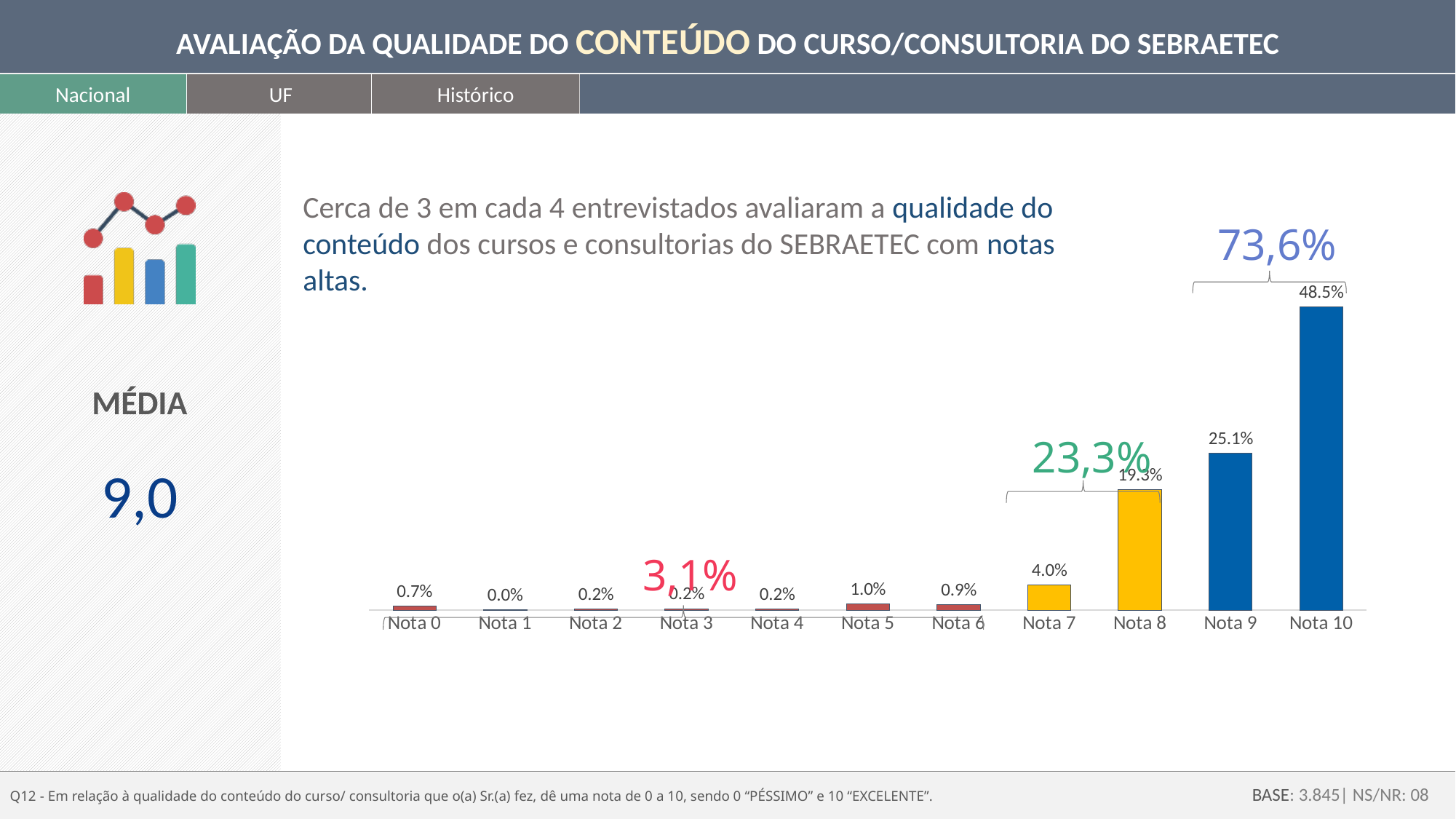
What combined percentage is shown above the bracket grouping Nota 7 and Nota 8? 23,3% How many categories are shown on the x axis? 11 What combined percentage is shown above the bracket grouping Nota 9 and Nota 10? 73,6% What is the value for Nota 8? 19.3% What is the value for Nota 5? 1.0% Which category has the highest value? Nota 10 What is the difference between the values for Nota 10 and Nota 9? 23.4% What is the value for Nota 7? 4.0% Which is larger, the value for Nota 9 or the value for Nota 8? Nota 9 Which category has the lowest value? Nota 1 What is the value for Nota 10? 48.5% What kind of chart is shown on the slide? Bar chart